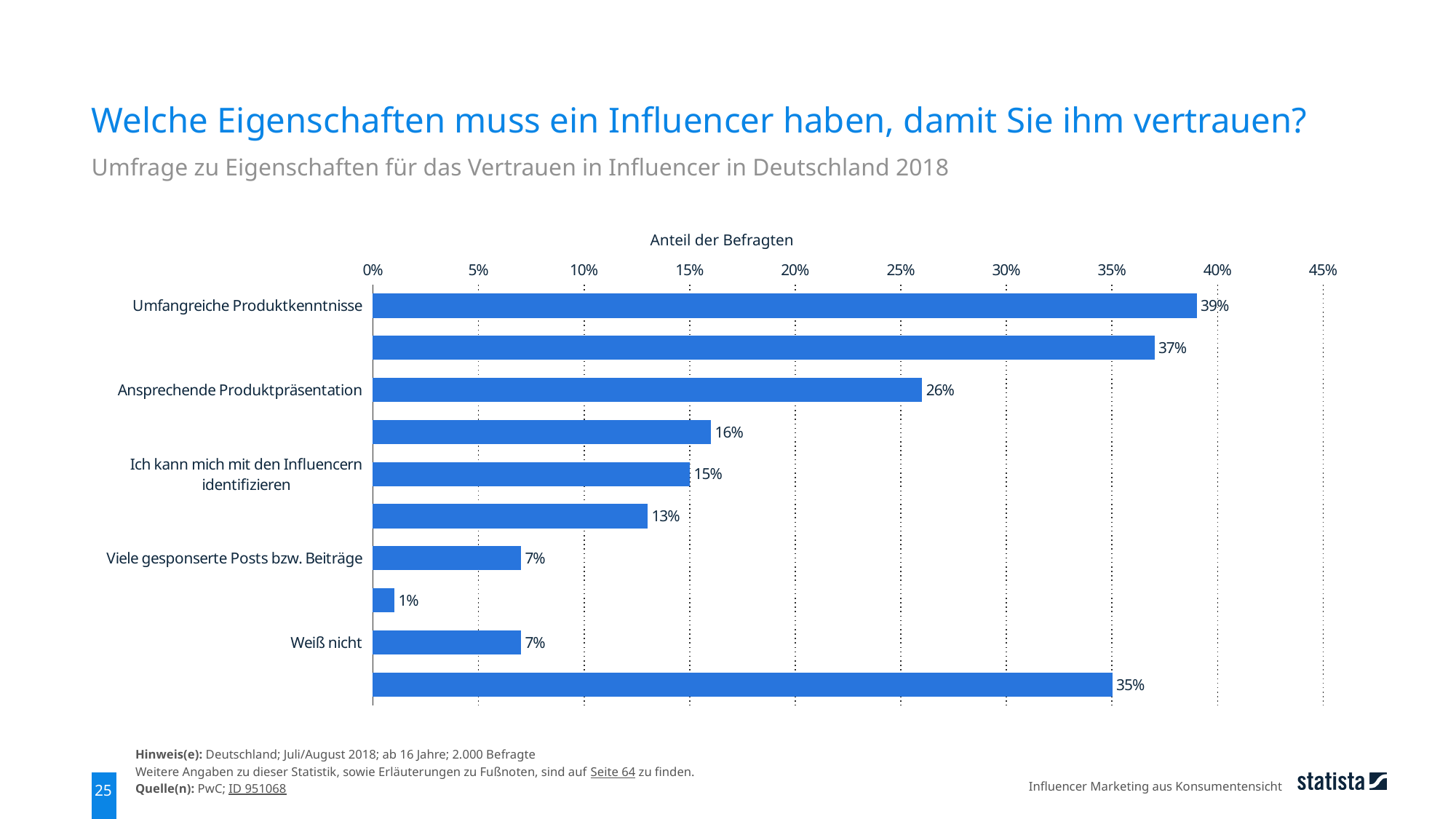
How many bars are plotted in the chart? 10 What is the value for Weiß nicht? 7% What is the label of the horizontal axis? Anteil der Befragten What is the value for Ansprechende Produktpräsentation? 26% What is the value for Umfangreiche Produktkenntnisse? 39% What is the lowest value shown in the chart? 1% What kind of chart is shown on the slide? bar chart What is the value for Viele gesponserte Posts bzw. Beiträge? 7% Which category has the highest value? Umfangreiche Produktkenntnisse Which is larger, Ansprechende Produktpräsentation or Ich kann mich mit den Influencern identifizieren? Ansprechende Produktpräsentation What is the difference between Umfangreiche Produktkenntnisse and Ansprechende Produktpräsentation? 13% What is the value for Ich kann mich mit den Influencern identifizieren? 15%